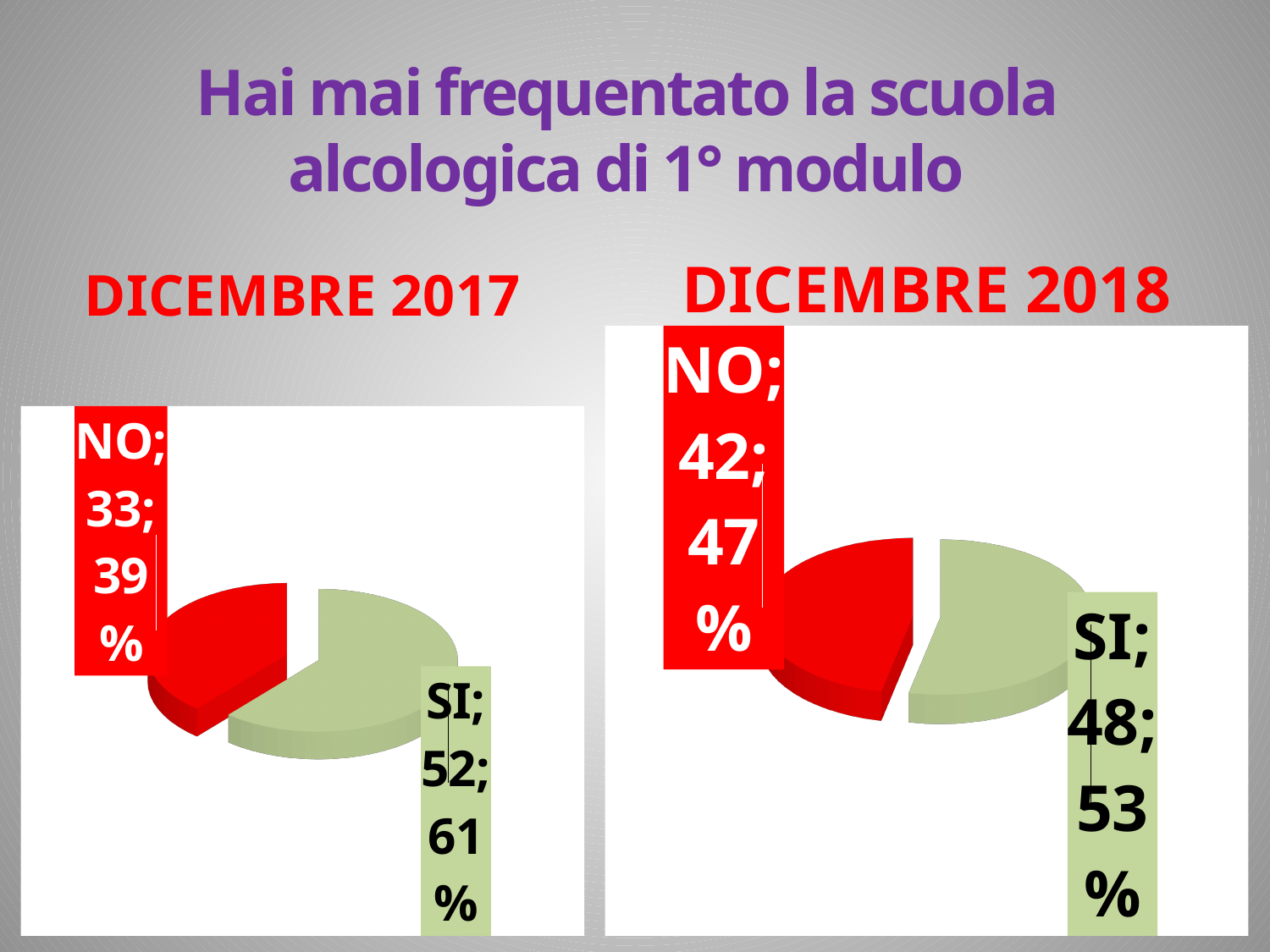
How many slices does the DICEMBRE 2018 pie chart have? 2 In the DICEMBRE 2017 chart, what percentage share does NO have? 39% In the DICEMBRE 2018 chart, what is the value for SI? 48 In the DICEMBRE 2018 chart, which category is the largest? SI Which is larger: the NO value in DICEMBRE 2017 or the NO value in DICEMBRE 2018? DICEMBRE 2018 In the DICEMBRE 2017 chart, what is the value for NO? 33 In the DICEMBRE 2017 chart, what percentage share does SI have? 61% In the DICEMBRE 2017 chart, what is the difference between the SI and NO values? 19 In the DICEMBRE 2018 chart, what percentage share does NO have? 47% In the DICEMBRE 2018 chart, what is the difference between the SI and NO values? 6 In the DICEMBRE 2017 chart, which category is the smallest? NO What kind of chart is shown under DICEMBRE 2017? Pie chart